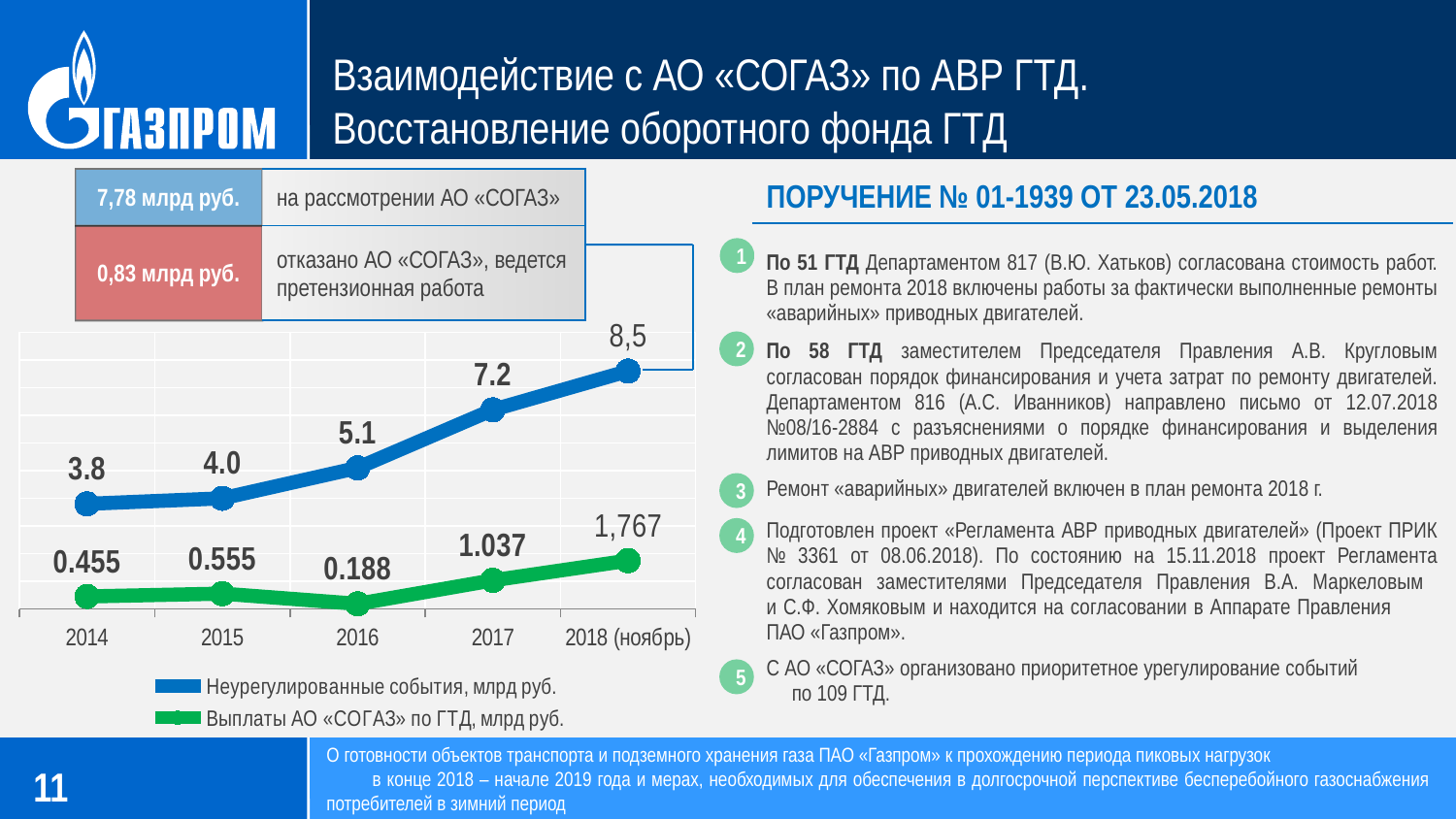
How many years (points) are plotted along the x axis of the chart? 5 What is the value of «Выплаты АО «СОГАЗ» по ГТД, млрд руб.» for 2017? 1.037 Which is larger: «Выплаты АО «СОГАЗ» по ГТД» in 2015 or in 2014? 2015 How many series does the chart legend list? 2 What is the difference between the «Неурегулированные события» values for 2017 and 2016? 2.1 What is the value of «Неурегулированные события, млрд руб.» for 2018 (ноябрь)? 8,5 Does the «Неурегулированные события, млрд руб.» series rise or fall from 2014 to 2018 (ноябрь)? rise In which year is «Неурегулированные события, млрд руб.» highest? 2018 (ноябрь) What is the value of «Неурегулированные события, млрд руб.» for 2016? 5.1 What type of chart is shown on the slide? line chart In which year is «Выплаты АО «СОГАЗ» по ГТД, млрд руб.» lowest? 2016 What colour is the line for «Выплаты АО «СОГАЗ» по ГТД, млрд руб.»? green